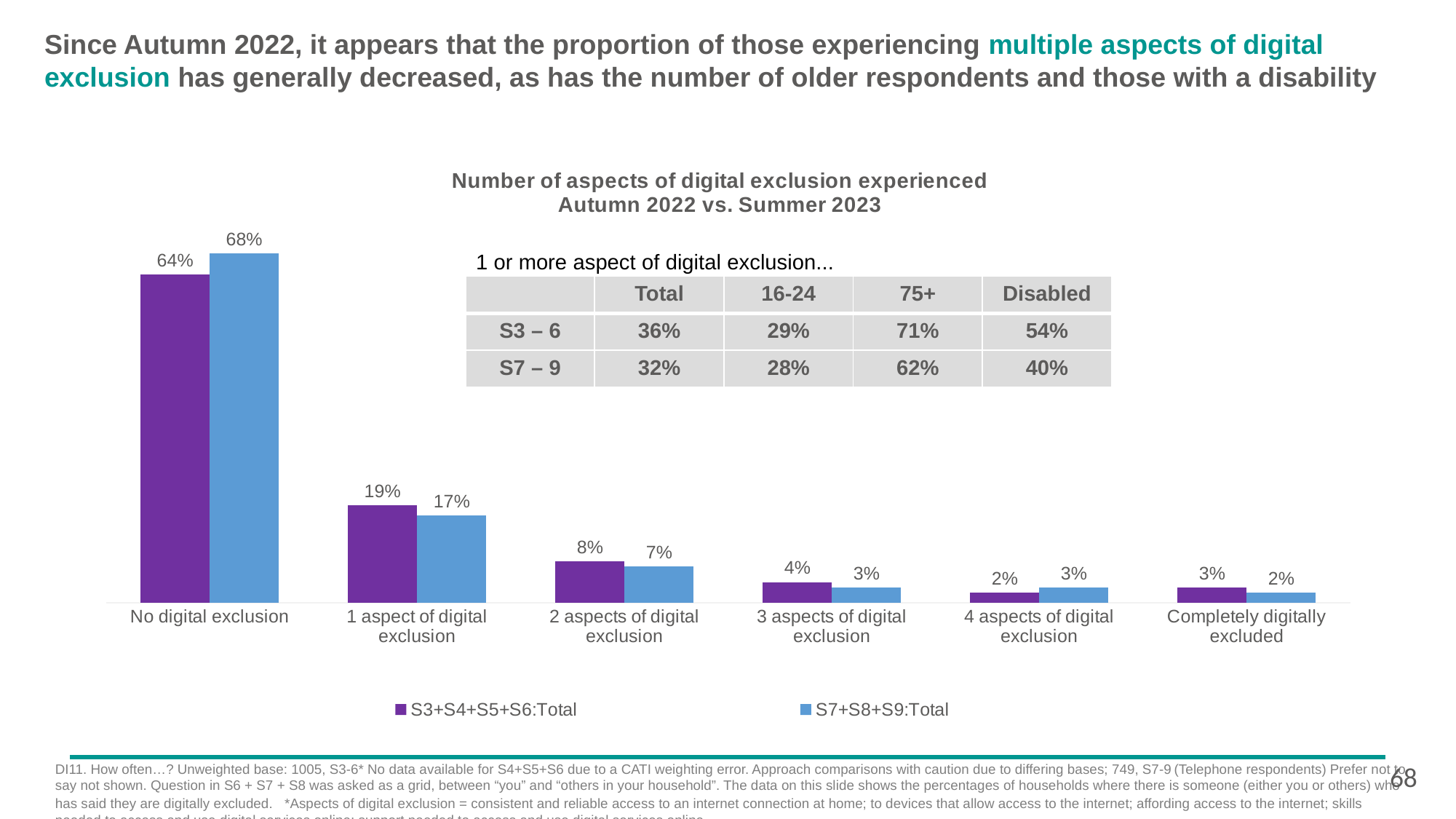
For '4 aspects of digital exclusion', which series has the larger value, S3+S4+S5+S6:Total or S7+S8+S9:Total? S7+S8+S9:Total What is the value for 'Completely digitally excluded' in the S3+S4+S5+S6:Total series? 3% What kind of chart is shown on the slide? Bar chart How many series does the chart legend list? 2 What is the value for 'No digital exclusion' in the S7+S8+S9:Total series? 68% What is the difference between the S3+S4+S5+S6:Total and S7+S8+S9:Total values for '1 aspect of digital exclusion'? 2% What is the value for 'No digital exclusion' in the S3+S4+S5+S6:Total series? 64% What is the value for '1 aspect of digital exclusion' in the S7+S8+S9:Total series? 17% What is the title of the chart? Number of aspects of digital exclusion experienced Autumn 2022 vs. Summer 2023 What is the difference between the S7+S8+S9:Total and S3+S4+S5+S6:Total values for 'No digital exclusion'? 4% Which category has the highest value in the S3+S4+S5+S6:Total series? No digital exclusion How many categories are shown on the x axis of the chart? 6